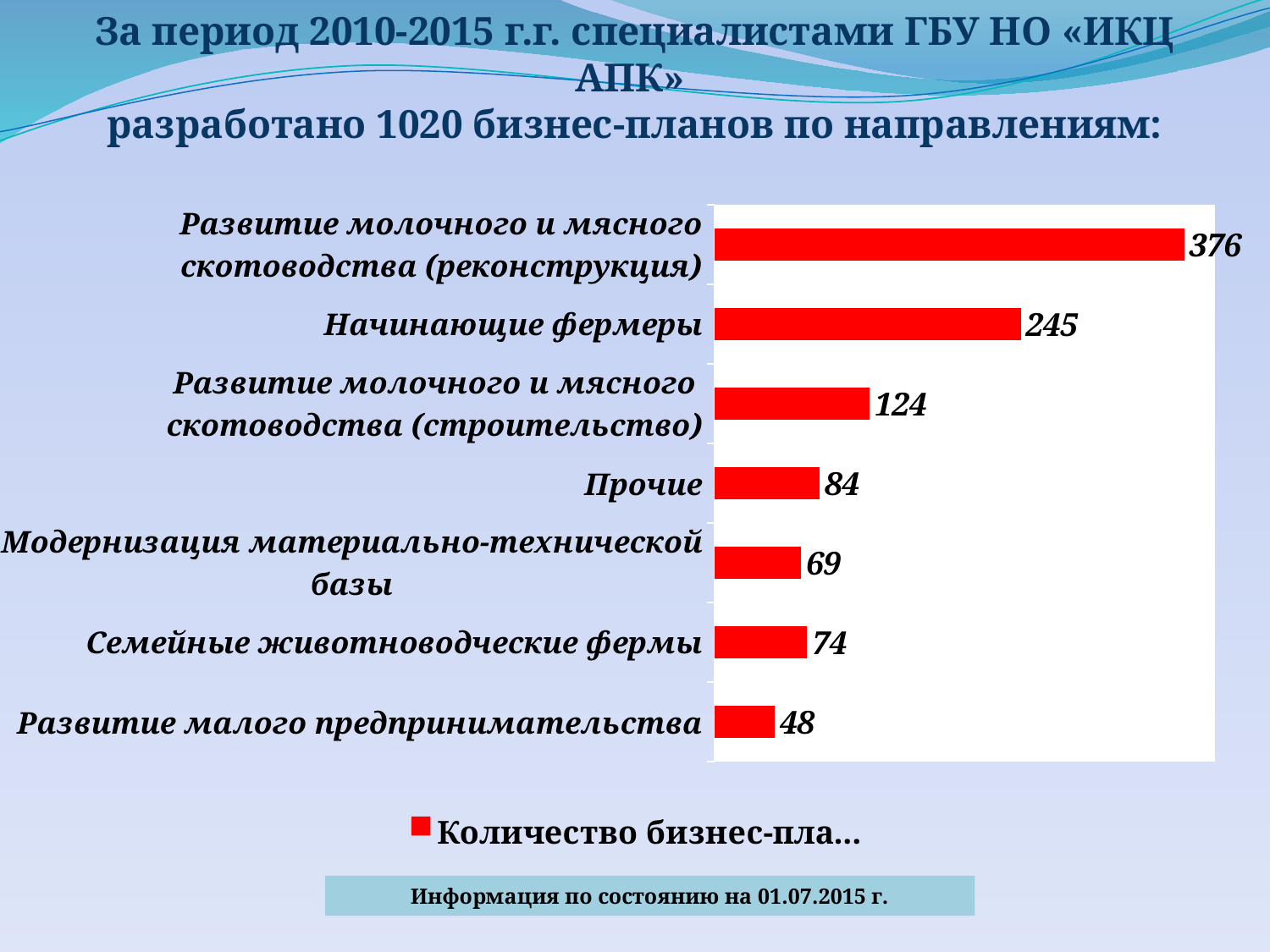
How many categories are shown in the chart? 7 What kind of chart is shown on the slide? Bar chart Which category has the highest value? Развитие молочного и мясного скотоводства (реконструкция) What colour are the bars in the chart? Red Which category has the lowest value? Развитие малого предпринимательства What is the value for «Прочие»? 84 What is the difference between «Развитие молочного и мясного скотоводства (реконструкция)» and «Начинающие фермеры»? 131 What is the difference between «Прочие» and «Семейные животноводческие фермы»? 10 Which is larger: «Семейные животноводческие фермы» or «Модернизация материально-технической базы»? Семейные животноводческие фермы What is the value for «Модернизация материально-технической базы»? 69 What is the value for «Начинающие фермеры»? 245 What is the value for «Развитие малого предпринимательства»? 48